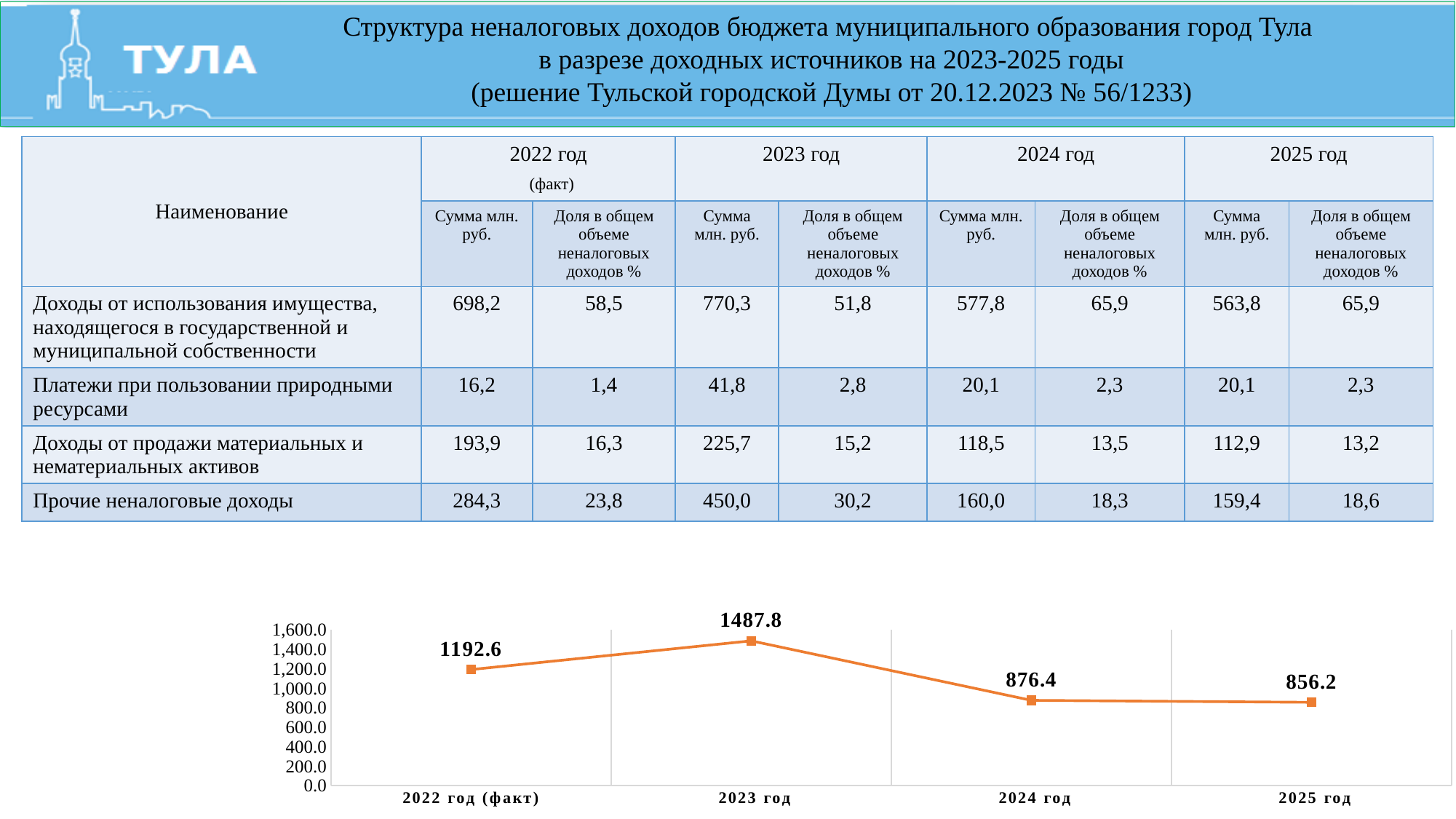
What is the value plotted for 2024 год in the line chart? 876.4 What is the difference between the 2023 год and 2024 год values in the line chart? 611.4 Which year has the lowest value in the line chart? 2025 год How many data points are plotted in the line chart? 4 What is the value plotted for 2025 год in the line chart? 856.2 What type of chart is shown at the bottom of the slide? line chart What is the highest value shown on the vertical axis of the line chart? 1,600.0 What is the value plotted for 2022 год (факт) in the line chart? 1192.6 What is the value plotted for 2023 год in the line chart? 1487.8 Does the line chart rise or fall from 2023 год to 2025 год? fall In the line chart, which is larger: the value for 2022 год (факт) or the value for 2024 год? 2022 год (факт) Which year has the highest value in the line chart? 2023 год